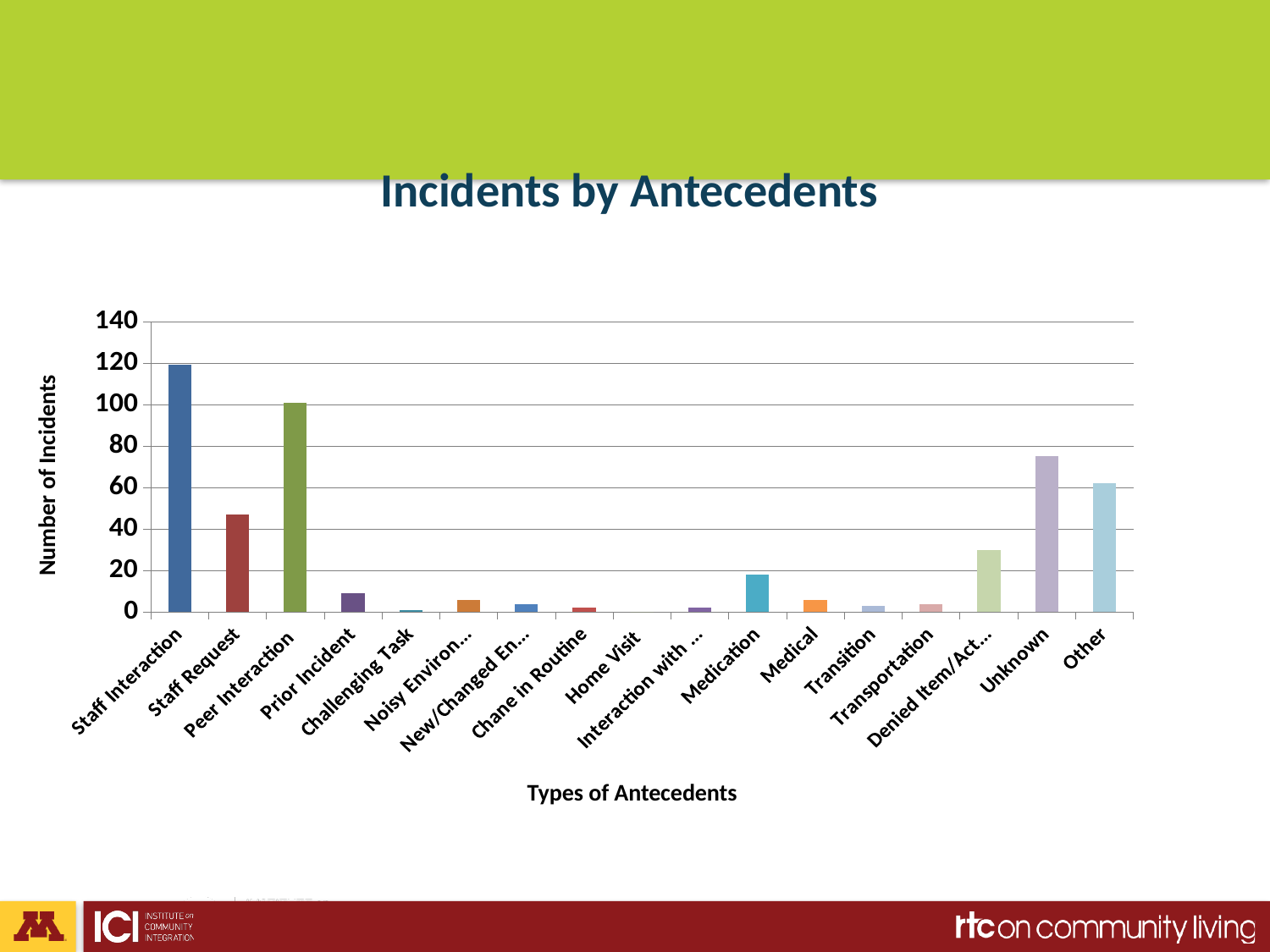
Is the value for Unknown greater or less than 60? greater Which antecedent category has the lowest number of incidents? Home Visit Is the value for Staff Interaction greater or less than 100? greater What type of chart is shown on the slide? Bar chart Which has more incidents, Unknown or Other? Unknown What is the title of the chart? Incidents by Antecedents Is the value for Peer Interaction greater or less than 80? greater Which has more incidents, Medication or Medical? Medication Which antecedent category has the highest number of incidents? Staff Interaction How many antecedent categories are shown on the x axis? 17 What is the label on the vertical axis of the chart? Number of Incidents